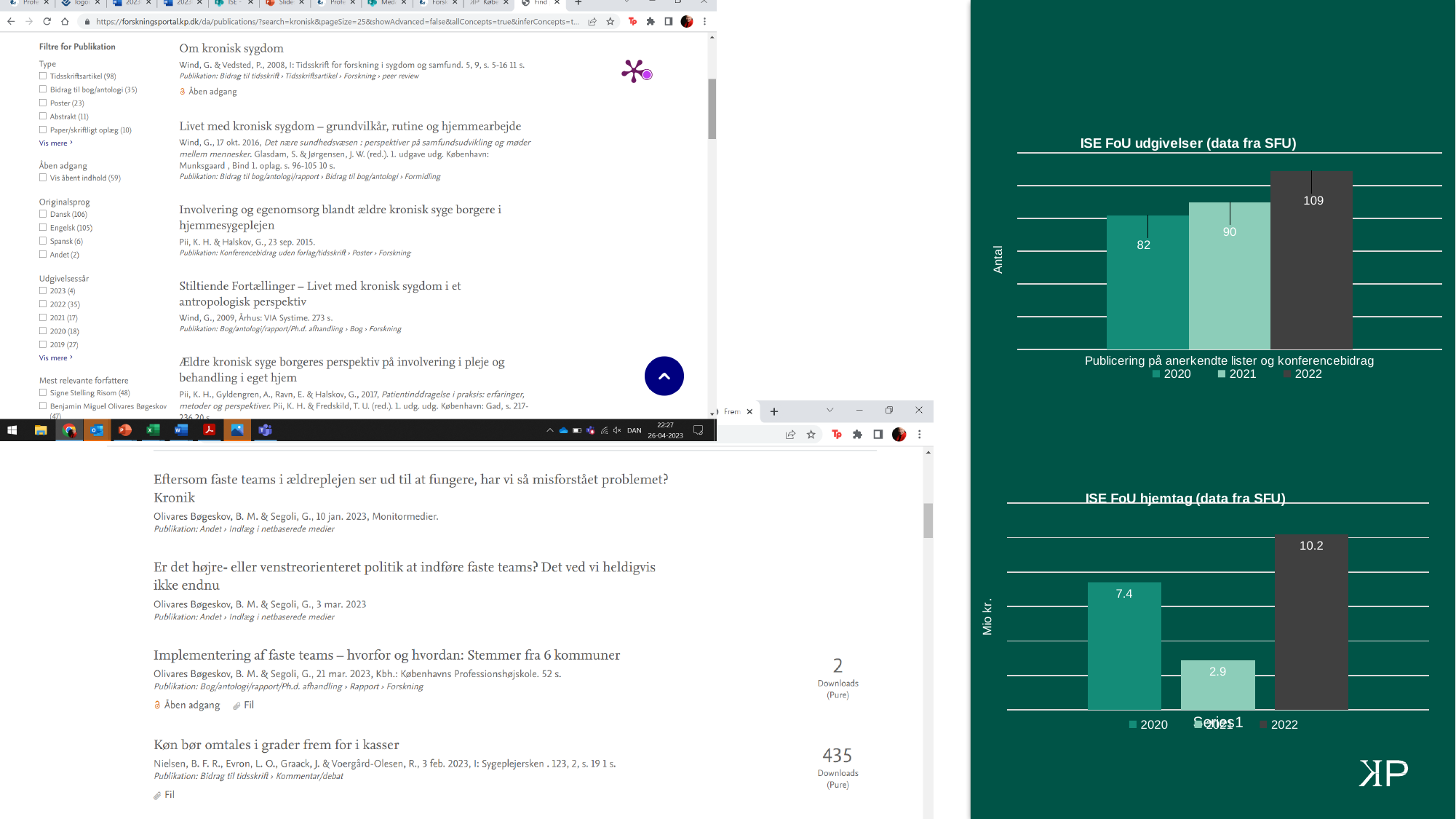
In the 'ISE FoU hjemtag (data fra SFU)' chart, what is the value for 2022? 10.2 What kind of chart is 'ISE FoU hjemtag (data fra SFU)'? bar chart In the 'ISE FoU hjemtag (data fra SFU)' chart, which is larger, the value for 2020 or the value for 2021? 2020 In the 'ISE FoU udgivelser (data fra SFU)' chart, what is the value for 2022? 109 In the 'ISE FoU hjemtag (data fra SFU)' chart, which year has the highest value? 2022 In the 'ISE FoU udgivelser (data fra SFU)' chart, which year has the lowest value? 2020 In the 'ISE FoU udgivelser (data fra SFU)' chart, what is the y-axis label? Antal In the 'ISE FoU udgivelser (data fra SFU)' chart, what is the value for 2020? 82 In the 'ISE FoU hjemtag (data fra SFU)' chart, what is the value for 2021? 2.9 In the 'ISE FoU udgivelser (data fra SFU)' chart, do the values rise or fall from 2020 to 2022? rise In the 'ISE FoU hjemtag (data fra SFU)' chart, what is the difference between the 2020 and 2021 values? 4.5 In the 'ISE FoU udgivelser (data fra SFU)' chart, what is the difference between the 2022 and 2021 values? 19